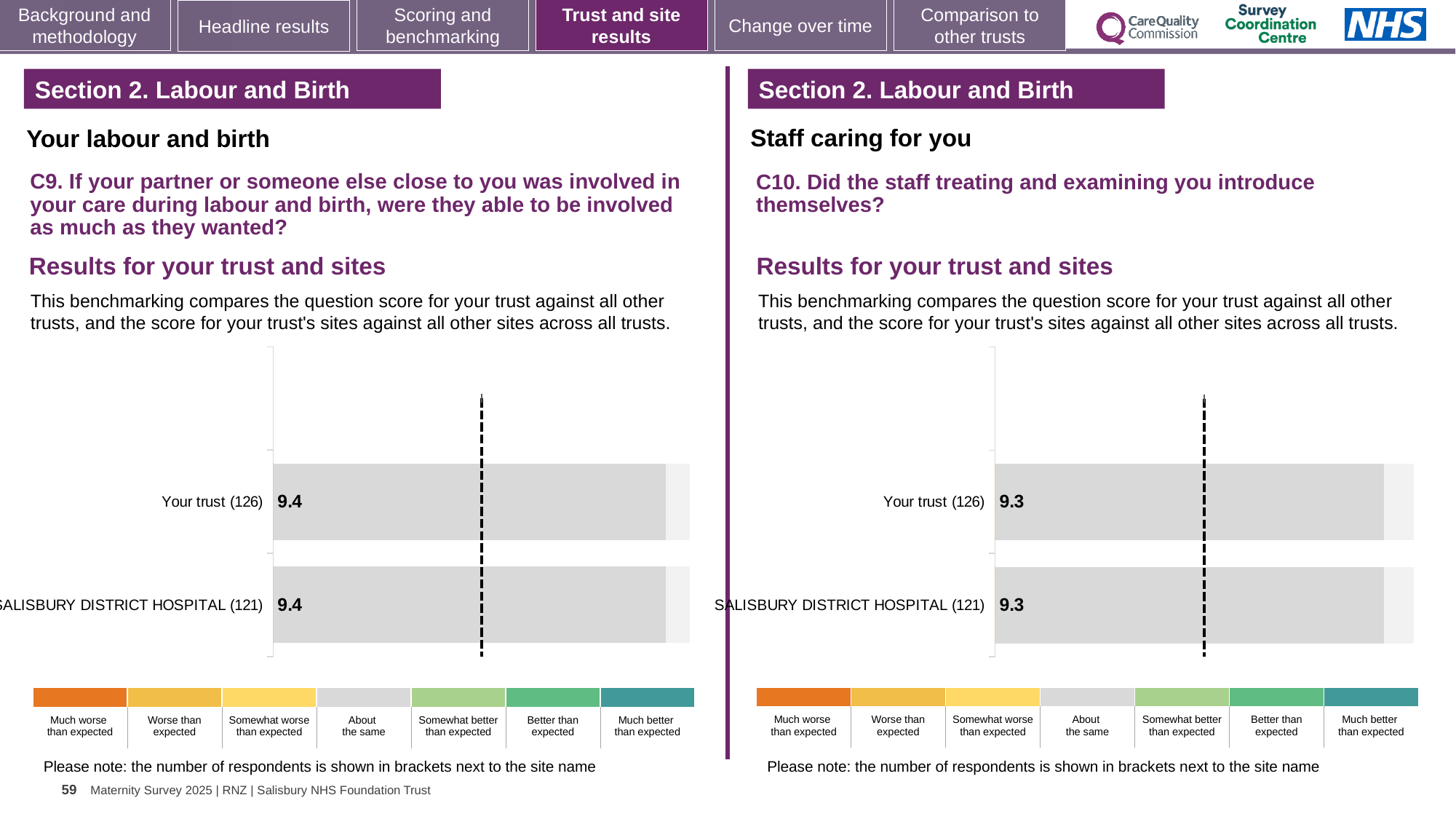
In the left chart (C9), what is the difference between the Your trust score and the Salisbury District Hospital score? 0 Is the Your trust score in the right chart (C10) higher or lower than the Your trust score in the left chart (C9)? Lower In the left chart (C9), what is the score for Salisbury District Hospital? 9.4 In the left chart (C9), how many respondents are shown in brackets for Salisbury District Hospital? 121 In the right chart (C10), how many respondents are shown in brackets for Your trust? 126 In the left chart (C9), what is the score for Your trust? 9.4 In the right chart (C10), what is the score for Your trust? 9.3 How many bars are plotted in the right chart (C10)? 2 In the right chart (C10), what is the score for Salisbury District Hospital? 9.3 What type of chart is used in the left chart (C9)? Bar chart In the right chart (C10), what is the difference between the Your trust score and the Salisbury District Hospital score? 0 How many bars are plotted in the left chart (C9)? 2